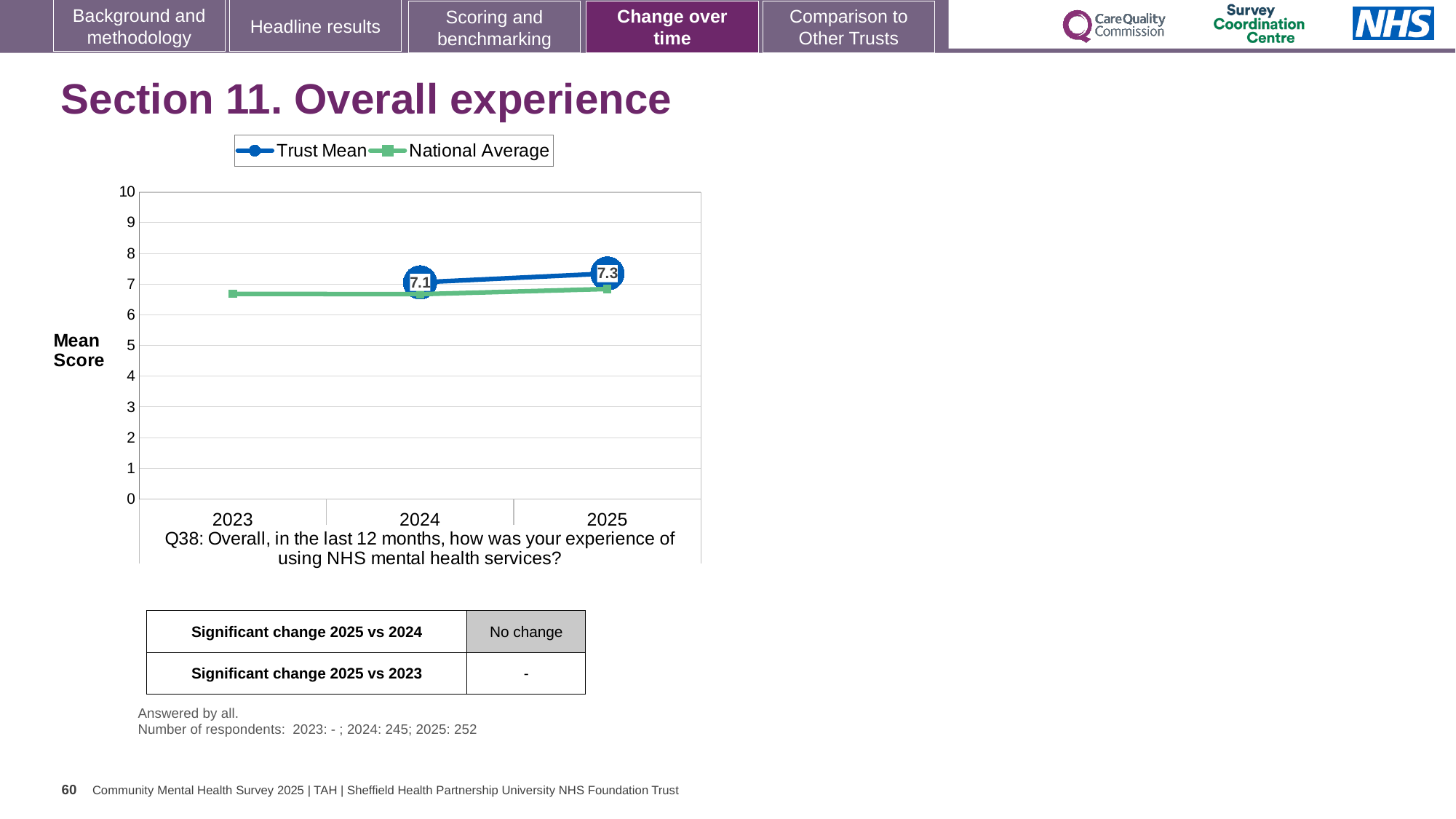
What is the Trust Mean value for 2025? 7.3 What is the label on the y axis of the chart? Mean Score Is the National Average value for 2023 greater or less than 5? greater In 2025, which series has the higher value, Trust Mean or National Average? Trust Mean Which year has the highest Trust Mean value? 2025 What kind of chart is shown on the slide? line chart What is the difference between the Trust Mean values for 2025 and 2024? 0.2 What is the Trust Mean value for 2024? 7.1 How many series does the legend list? 2 How many years are shown on the x axis? 3 Does the Trust Mean rise or fall from 2024 to 2025? rises Which year has the higher Trust Mean, 2024 or 2025? 2025